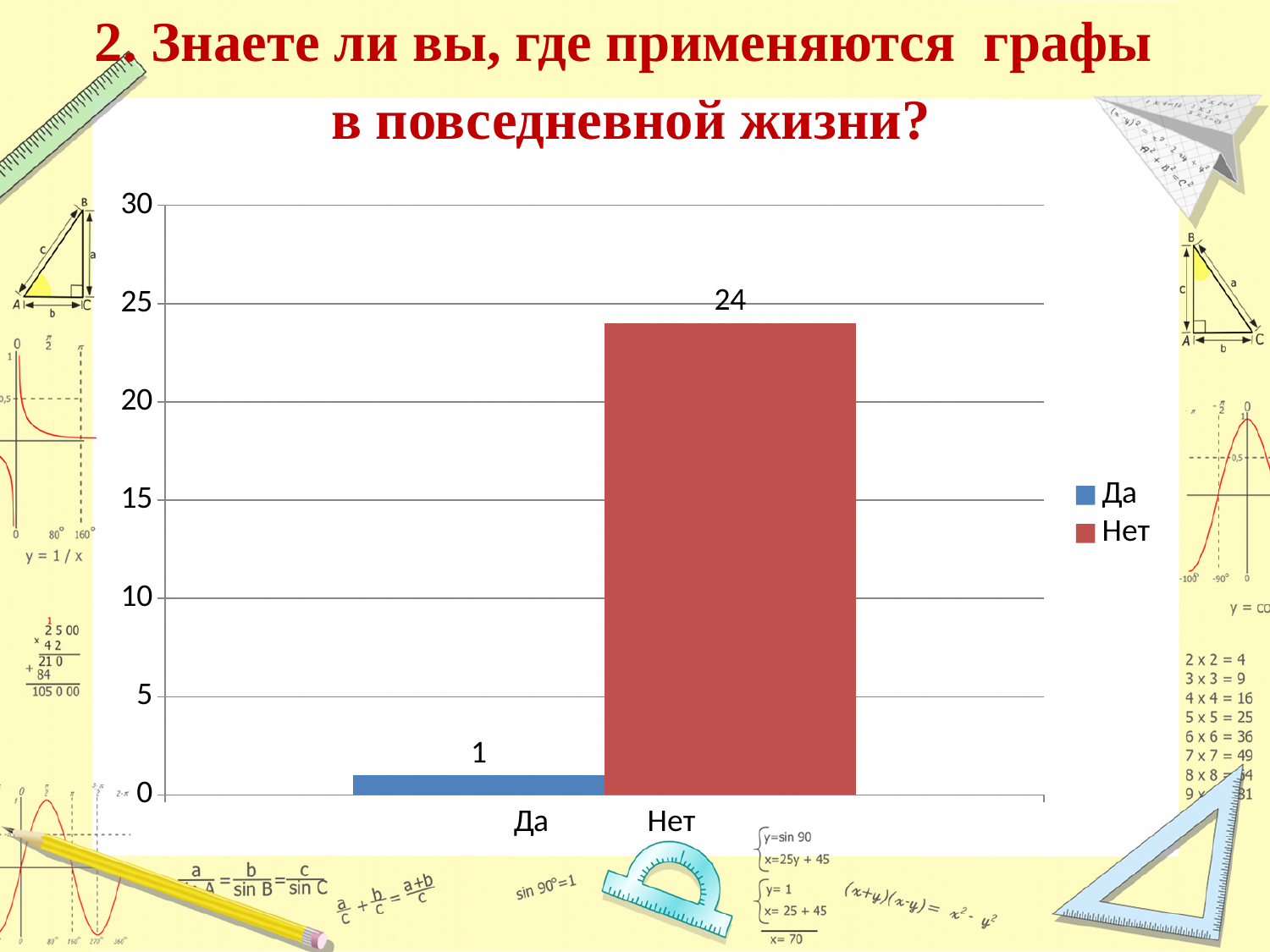
Which category has the lowest value? Да What colour is the bar for "Нет"? red Is the value for "Нет" greater or less than 20? greater What is the value for "Нет"? 24 How many categories are shown in the chart? 2 What kind of chart is shown on the slide? bar chart What is the value for "Да"? 1 Which category has the highest value? Нет Which is larger, the value for "Да" or the value for "Нет"? Нет Is the value for "Да" greater or less than 5? less What is the difference between the values for "Нет" and "Да"? 23 How many entries does the legend list? 2